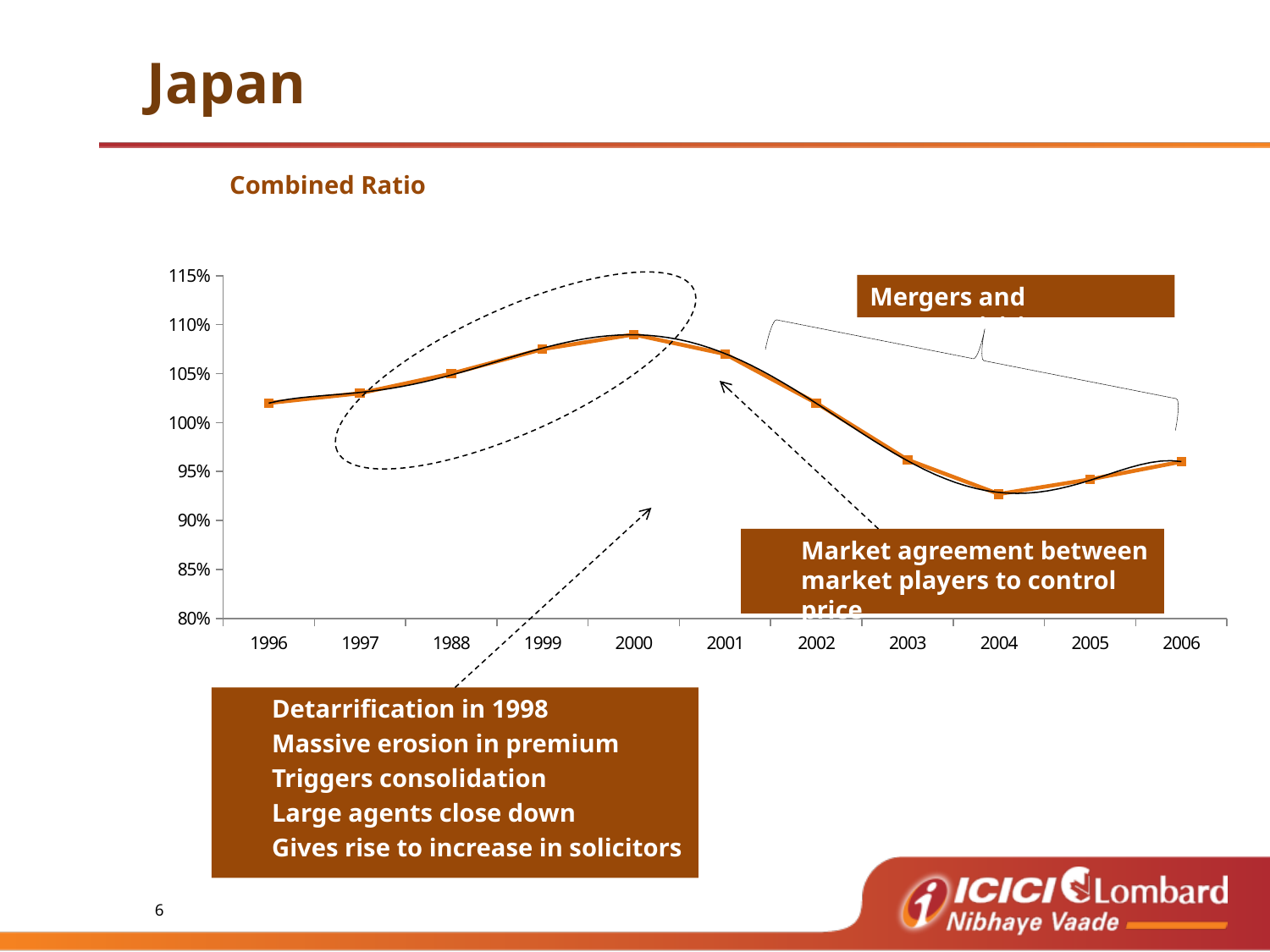
How many data points are plotted on the Combined Ratio chart? 11 Does the combined ratio rise or fall between 2000 and 2004? fall What is the title of the chart? Combined Ratio In which year is the combined ratio lowest? 2004 Is the combined ratio for 2003 greater or less than 100%? less Which year has a higher combined ratio, 1999 or 2003? 1999 Does the combined ratio rise or fall between 1996 and 2000? rise Is the combined ratio for 2004 greater or less than 95%? less In which year is the combined ratio highest? 2000 What kind of chart is shown on the slide? line chart Is the combined ratio for 2000 greater or less than 105%? greater